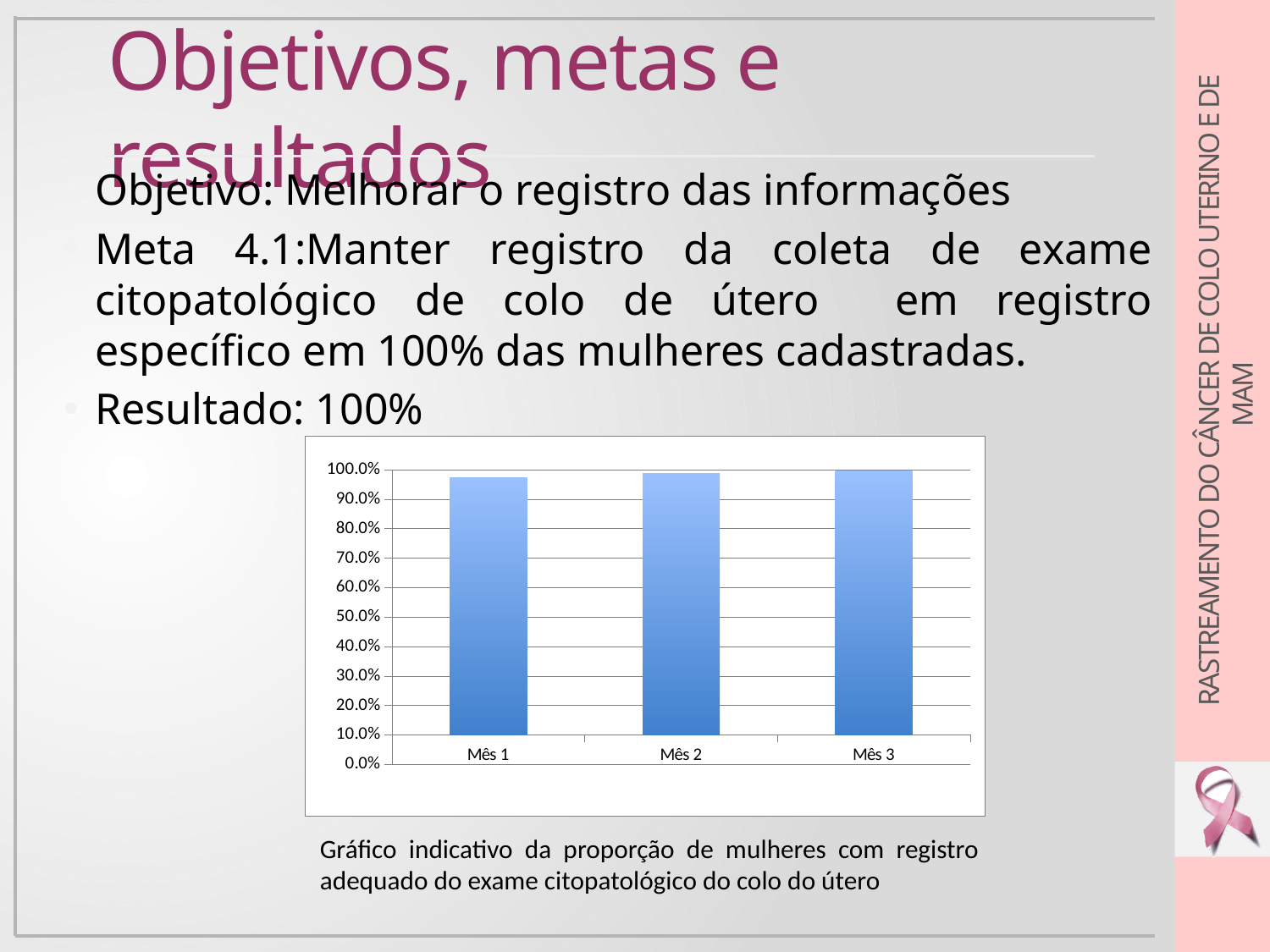
What is the highest tick label shown on the y axis of the chart? 100.0% Which category has the lowest bar in the chart? Mês 1 How many categories are plotted on the x axis of the chart? 3 Is the value for Mês 2 greater or less than 80.0%? greater Is the value for Mês 1 greater or less than 90.0%? greater Which category has the highest bar in the chart? Mês 3 Do the values rise or fall from Mês 1 to Mês 3? rise Which is larger, the value for Mês 1 or the value for Mês 3? Mês 3 What kind of chart is shown on the slide? bar chart What is the label of the first category on the x axis? Mês 1